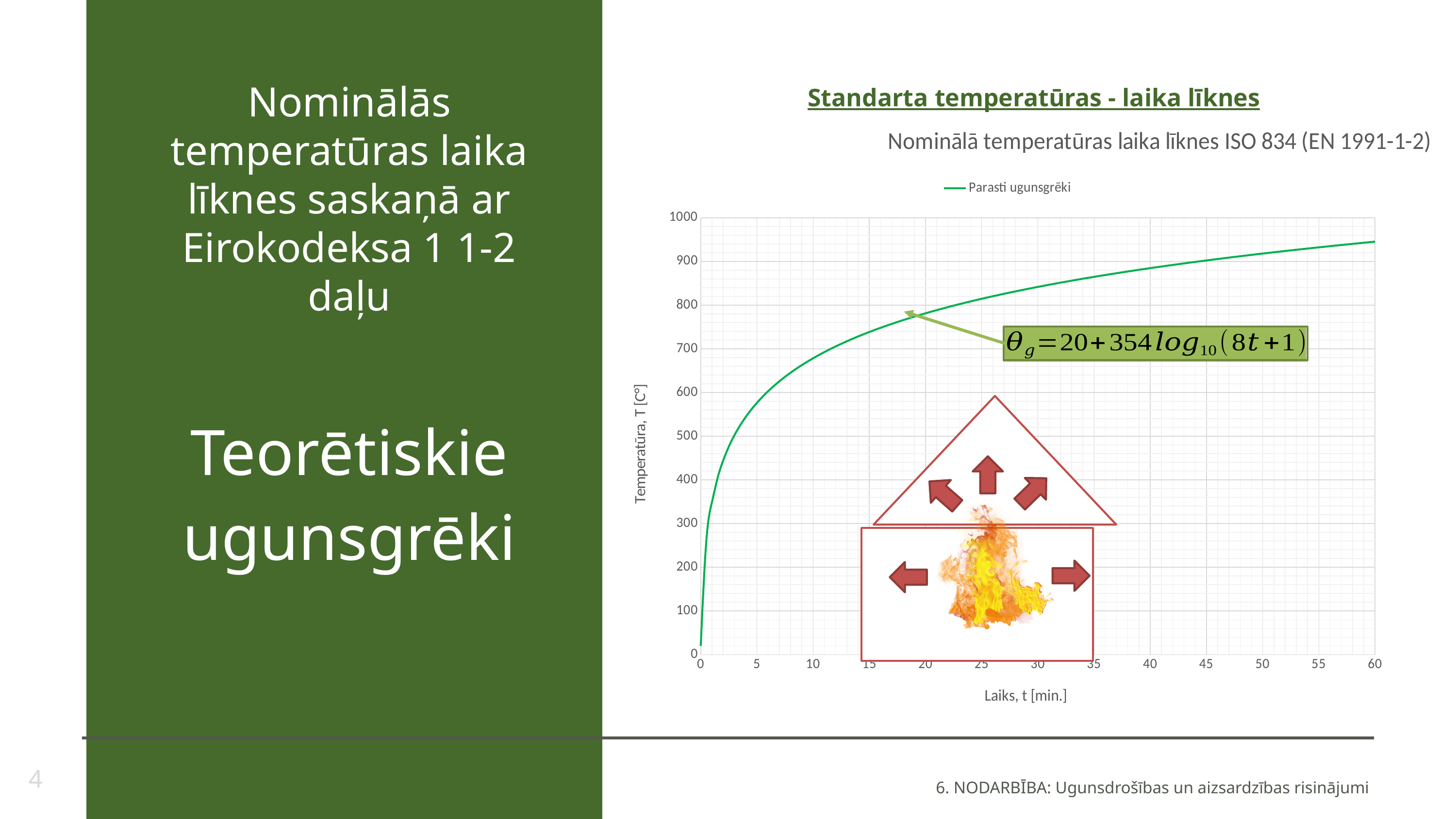
What is the name of the series shown in the chart legend? Parasti ugunsgrēki Is the temperature at 10 minutes greater or less than 600? greater Does the temperature rise or fall as time increases along the x axis? rise Is the temperature at 30 minutes greater or less than 800? greater Is the temperature at 60 minutes greater or less than 900? greater How many series does the chart legend list? 1 What kind of chart is shown on the slide? line chart What is the title of the chart? Nominālā temperatūras laika līknes ISO 834 (EN 1991-1-2)